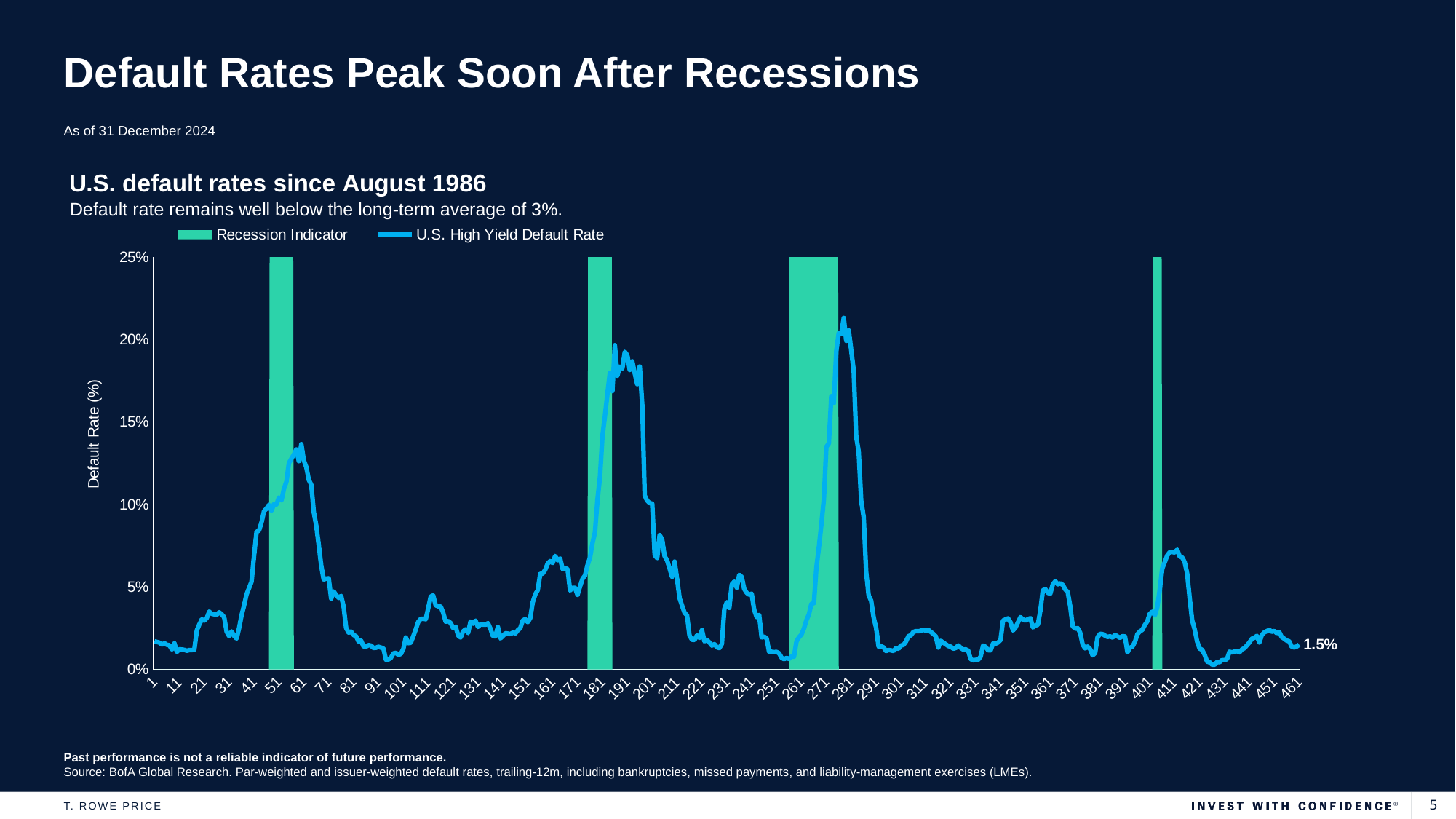
How many recession indicator bars are shown on the chart? 4 What is the label on the vertical axis of the chart? Default Rate (%) Is the peak of the default rate near x = 191 greater or less than 15%? greater Is the default rate at x = 1 greater or less than 5%? less What kind of chart is shown on the slide? line chart Is the default rate peak near x = 281 higher or lower than the peak near x = 191? higher What are the two entries in the chart legend? Recession Indicator; U.S. High Yield Default Rate Is the default rate peak near x = 61 greater or less than 10%? greater What is the U.S. High Yield Default Rate value printed at the end of the line? 1.5% How many series does the chart legend list? 2